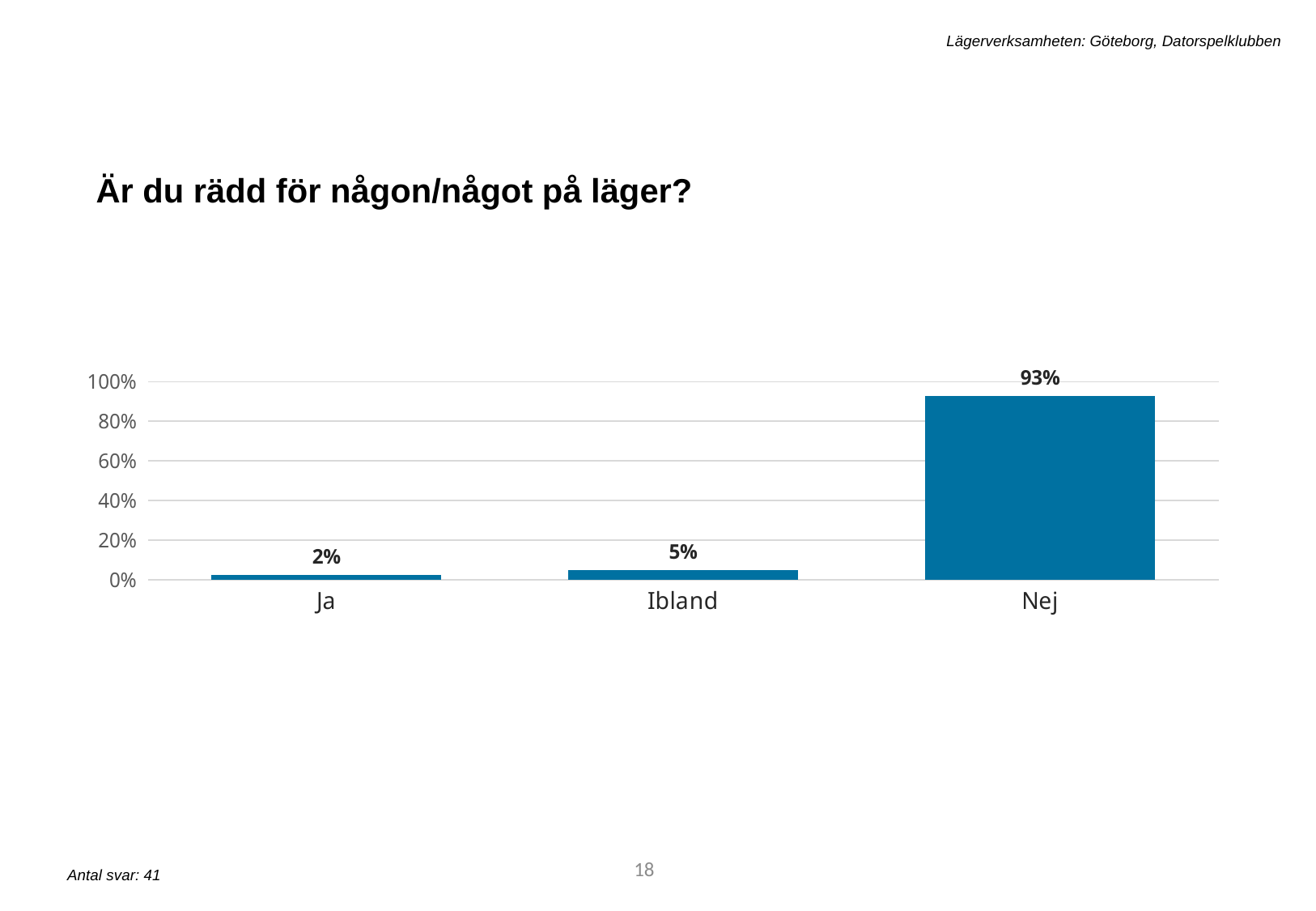
What is the title of the chart? Är du rädd för någon/något på läger? What is the difference between the values for Nej and Ibland? 88% Which category has the highest value? Nej What is the value for Ibland? 5% Is the value for Nej greater or less than 80%? greater How many categories are shown on the x axis? 3 What is the difference between the values for Ibland and Ja? 3% Which is larger, the value for Ibland or the value for Ja? Ibland Which category has the lowest value? Ja What is the value for Nej? 93% What kind of chart is shown on the slide? bar chart What is the value for Ja? 2%